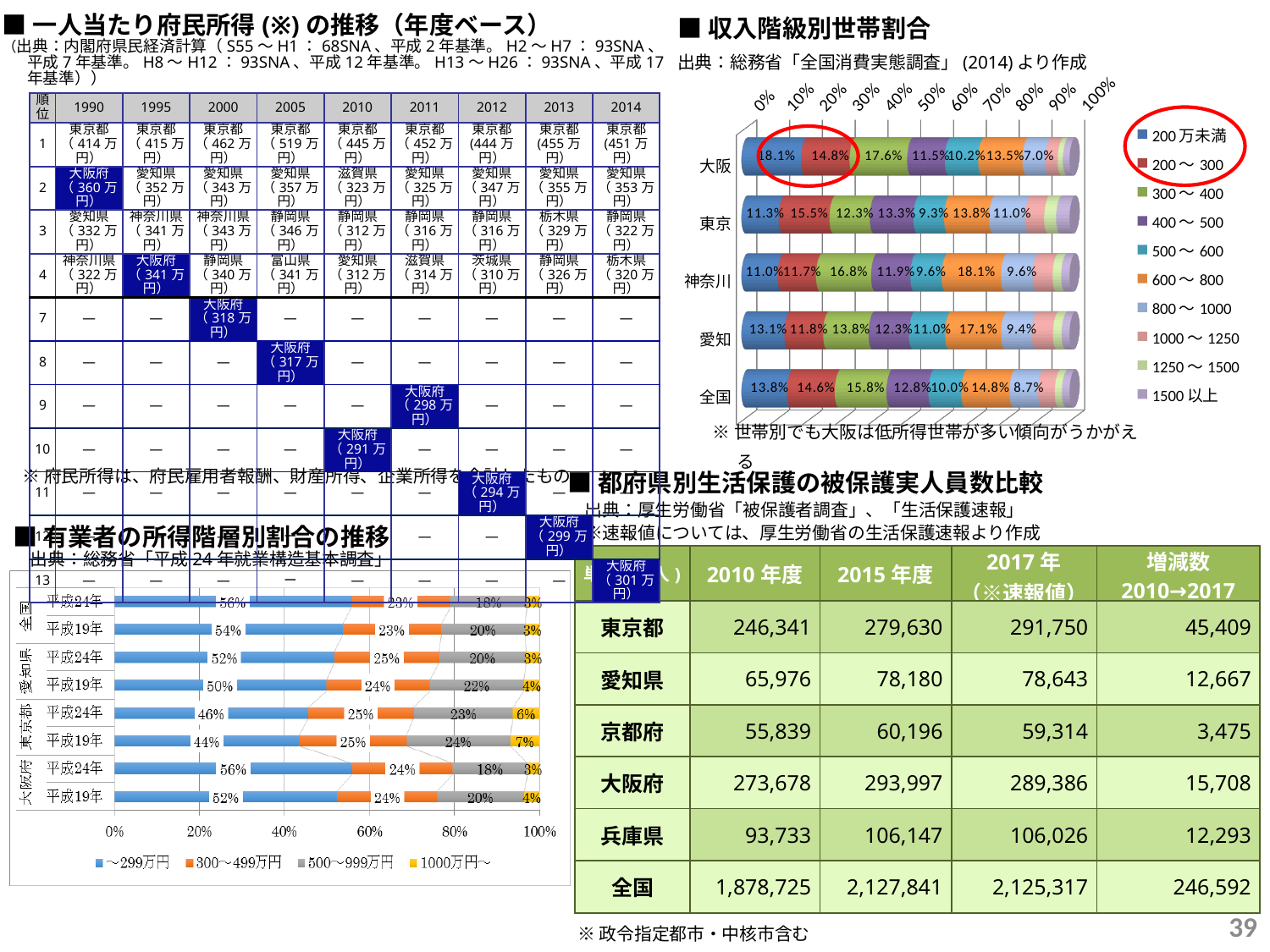
In the 有業者の所得階層別割合の推移 chart, what is the ～299万円 share for 東京都 in 平成24年? 46% In the 収入階級別世帯割合 chart, which region has the highest value for the 200万未満 segment? 大阪 In the 有業者の所得階層別割合の推移 chart, what is the 1000万円～ share for 東京都 in 平成19年? 7% In the 収入階級別世帯割合 chart, how many regions are plotted? 5 In the 収入階級別世帯割合 chart, what is the value of the 200～300 segment for 東京? 15.5% What kind of chart is the 収入階級別世帯割合 chart? Stacked bar chart In the 収入階級別世帯割合 chart, which region has the lowest value for the 200万未満 segment? 神奈川 In the 収入階級別世帯割合 chart, how many series does the legend list? 10 In the 収入階級別世帯割合 chart, what is the difference between the 200万未満 values for 大阪 and 全国? 4.3% In the 収入階級別世帯割合 chart, what is the value of the 200万未満 segment for 大阪? 18.1% In the 有業者の所得階層別割合の推移 chart, which is larger: the ～299万円 share for 大阪府 in 平成24年 or in 平成19年? 平成24年 In the 有業者の所得階層別割合の推移 chart, how many series does the legend list? 4